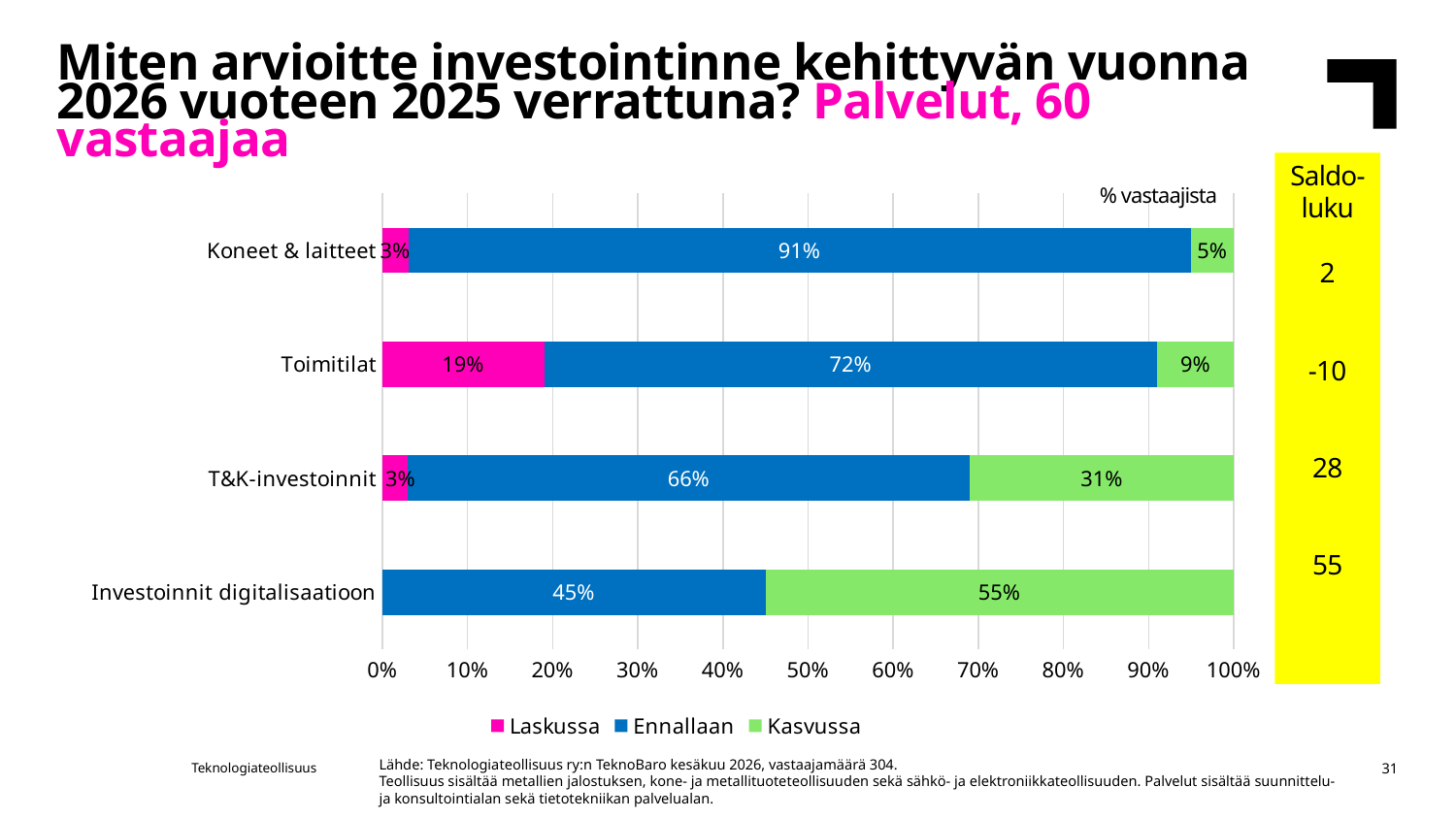
What is the "Kasvussa" value for T&K-investoinnit? 31% What is the difference between the "Ennallaan" values for Koneet & laitteet and Toimitilat? 19 percentage points What is the "Kasvussa" value for Investoinnit digitalisaatioon? 55% Which category has the highest "Kasvussa" share? Investoinnit digitalisaatioon What is the "Laskussa" value for Toimitilat? 19% How many series does the legend list? 3 Which is larger: the "Kasvussa" value for Toimitilat or for T&K-investoinnit? T&K-investoinnit What percentage of respondents answered "Ennallaan" for Koneet & laitteet? 91% What kind of chart is shown on the slide? Stacked bar chart What is the Saldoluku value shown for T&K-investoinnit? 28 How many categories are shown on the chart? 4 Which category has the lowest "Ennallaan" share? Investoinnit digitalisaatioon